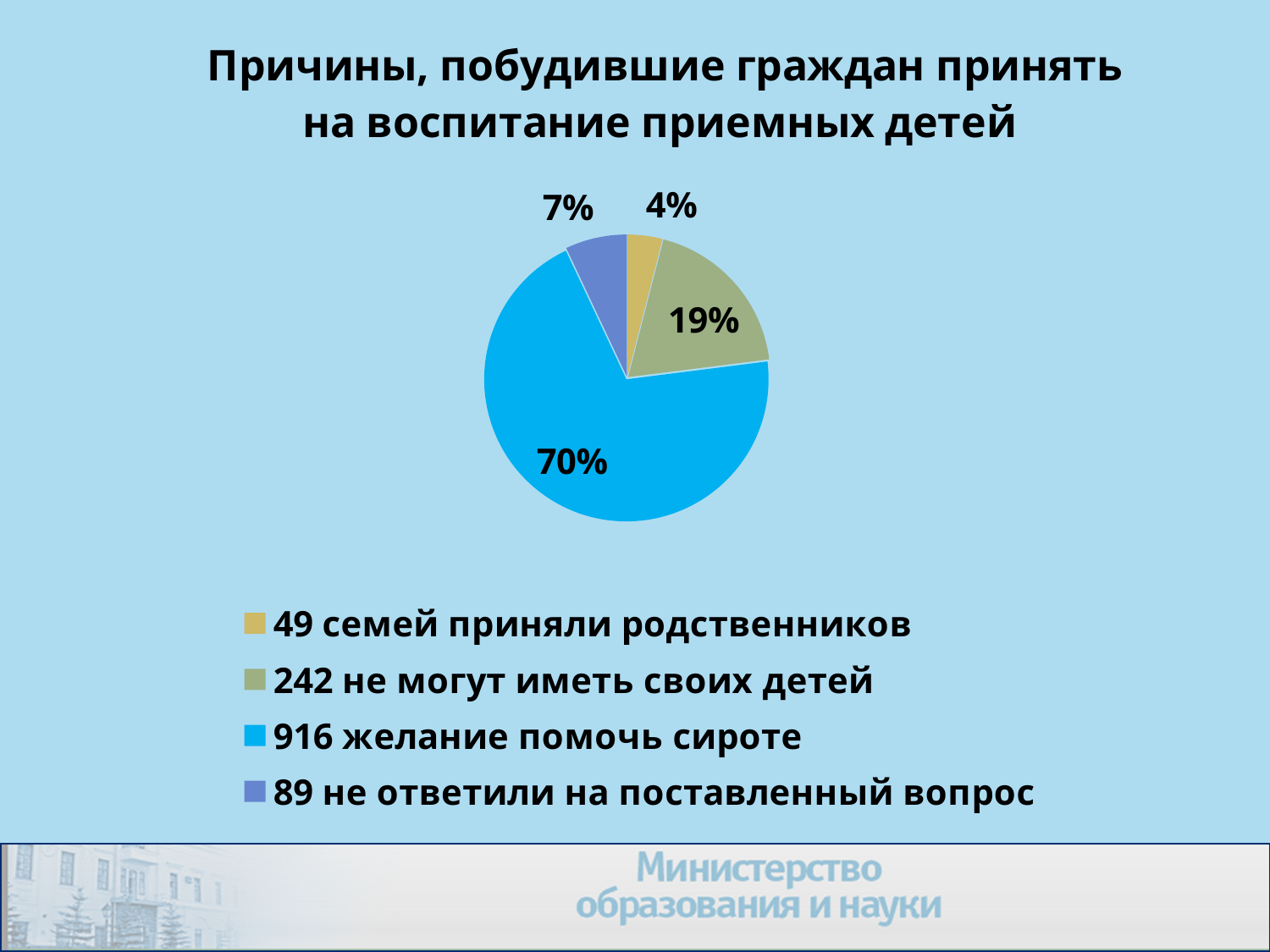
Which category has the smallest slice of the pie? 49 семей приняли родственников What colour is the slice for "916 желание помочь сироте"? blue What is the title of the chart on the slide? Причины, побудившие граждан принять на воспитание приемных детей Which slice is larger: "89 не ответили на поставленный вопрос" or "49 семей приняли родственников"? 89 не ответили на поставленный вопрос What percentage of the pie is labelled for "242 не могут иметь своих детей"? 19% Which category has the largest slice of the pie? 916 желание помочь сироте How many slices does the pie chart have? 4 What percentage of the pie is labelled for "916 желание помочь сироте"? 70% What is the difference in percentage points between the slice for "916 желание помочь сироте" and the slice for "242 не могут иметь своих детей"? 51 What kind of chart is shown on the slide? pie chart What percentage of the pie is labelled for "49 семей приняли родственников"? 4% What percentage of the pie is labelled for "89 не ответили на поставленный вопрос"? 7%